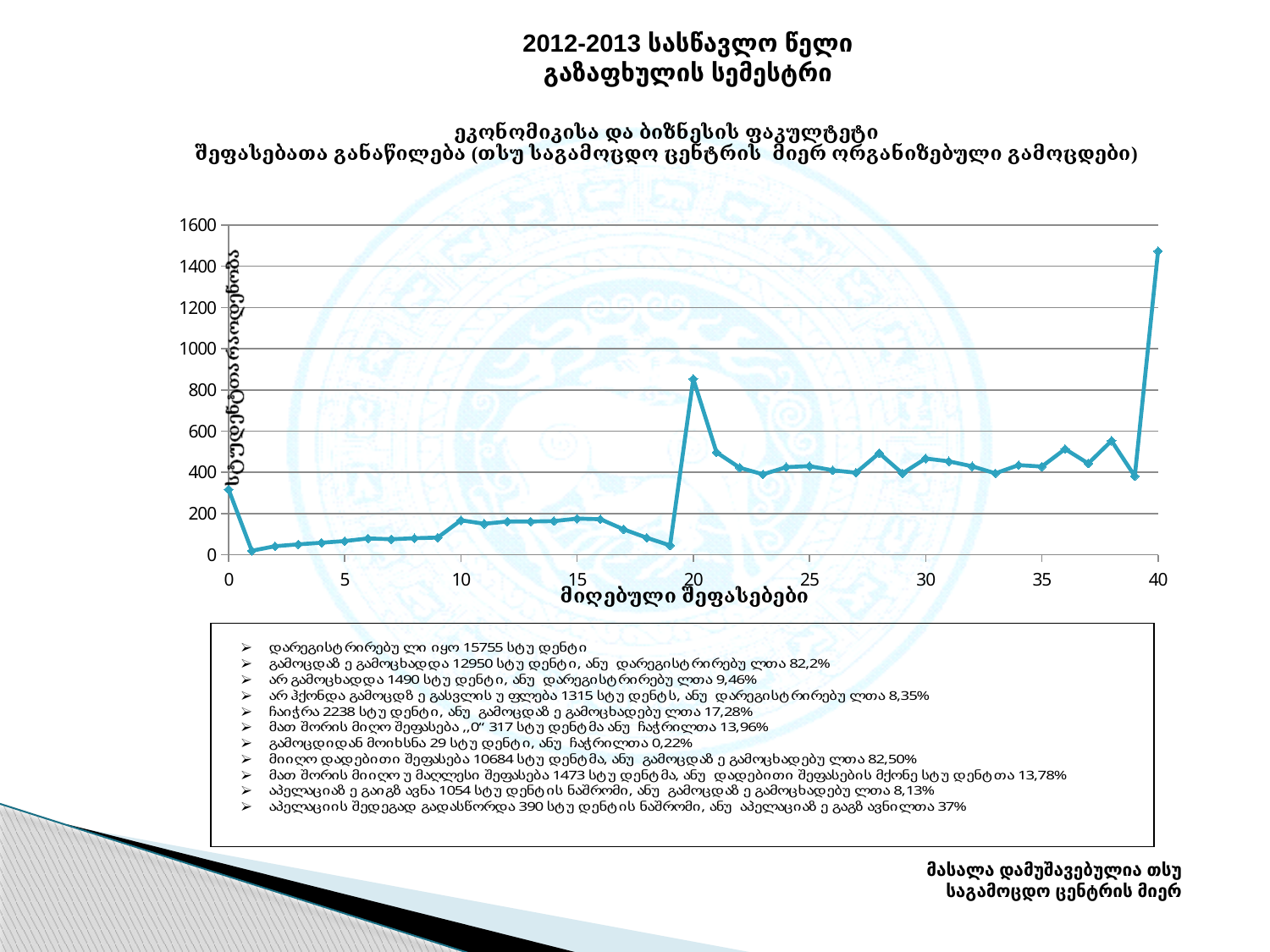
At which score on the x axis does the line reach its highest value? 40 Is the value at score 0 greater or less than 200? greater Is the value at score 20 greater or less than 800? greater Is the value at score 40 greater or less than 1400? greater At which score on the x axis does the line reach its lowest value? 1 What is the label of the x axis? მიღებული შეფასებები Does the line rise or fall between score 20 and score 21? fall What kind of chart is shown on the slide? line chart Which has the larger value, score 10 or score 30? 30 Which has the larger value, score 20 or score 40? 40